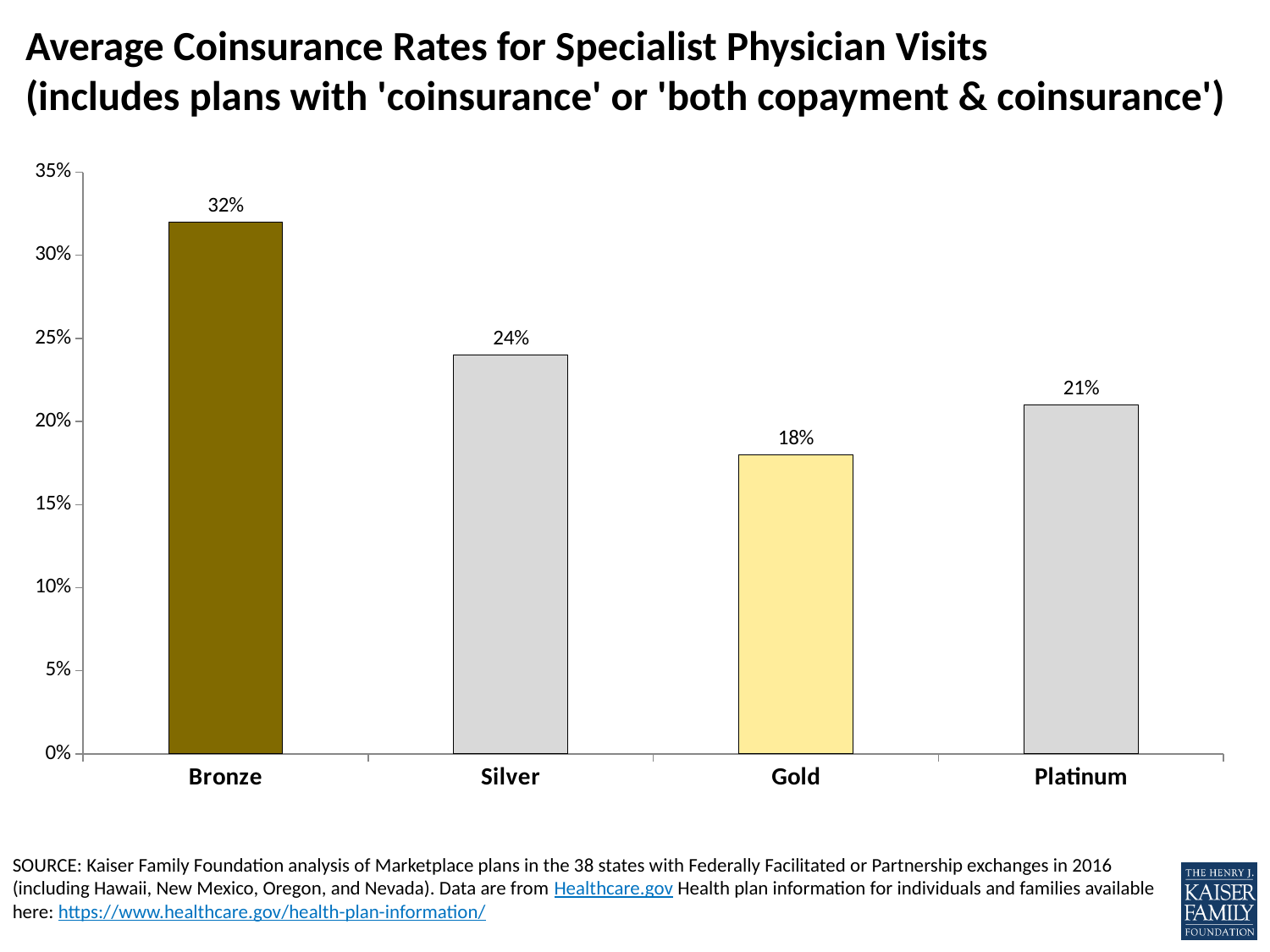
Which has a higher average coinsurance rate, Silver or Platinum? Silver What kind of chart is shown on the slide? Bar chart What is the difference in average coinsurance rate between Bronze and Gold plans? 14 percentage points What is the average coinsurance rate for specialist physician visits for Bronze plans? 32% What is the average coinsurance rate for Silver plans? 24% Is the value for Platinum greater or less than 25%? less Which plan tier has the lowest average coinsurance rate? Gold How many plan tiers are shown in the chart? 4 Which plan tier has the highest average coinsurance rate? Bronze What is the average coinsurance rate for Gold plans? 18% What is the average coinsurance rate for Platinum plans? 21% Which bar is shown in dark brown? Bronze